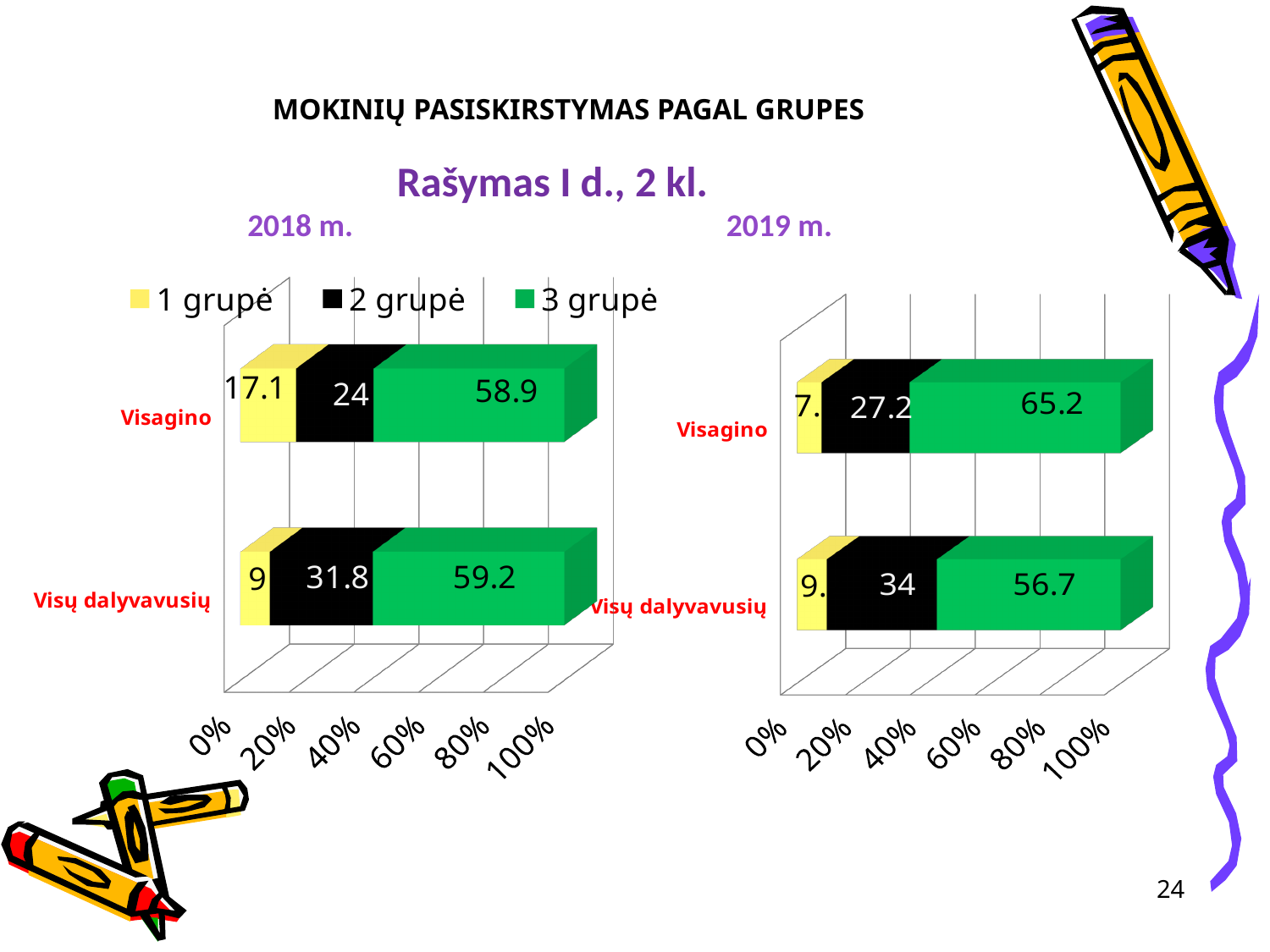
In the 2019 m. chart, which category has the larger 3 grupė value, Visagino or Visų dalyvavusių? Visagino In the 2019 m. chart, what is the value of 2 grupė for Visų dalyvavusių? 34 In the 2018 m. chart, what is the difference between the 3 grupė and 2 grupė values for Visų dalyvavusių? 27.4 In the 2019 m. chart, what is the value of 2 grupė for Visagino? 27.2 In the 2018 m. chart, what is the value of 3 grupė for Visagino? 58.9 What kind of chart is the 2018 m. chart? Stacked bar chart In the 2019 m. chart, what is the value of 3 grupė for Visagino? 65.2 In the 2018 m. chart, what is the difference between the 3 grupė and 2 grupė values for Visagino? 34.9 What colour represents 3 grupė in the legend? Green How many categories are shown in the 2018 m. chart? 2 In the 2018 m. chart, what is the value of 2 grupė for Visų dalyvavusių? 31.8 How many series does the legend list for the charts? 3